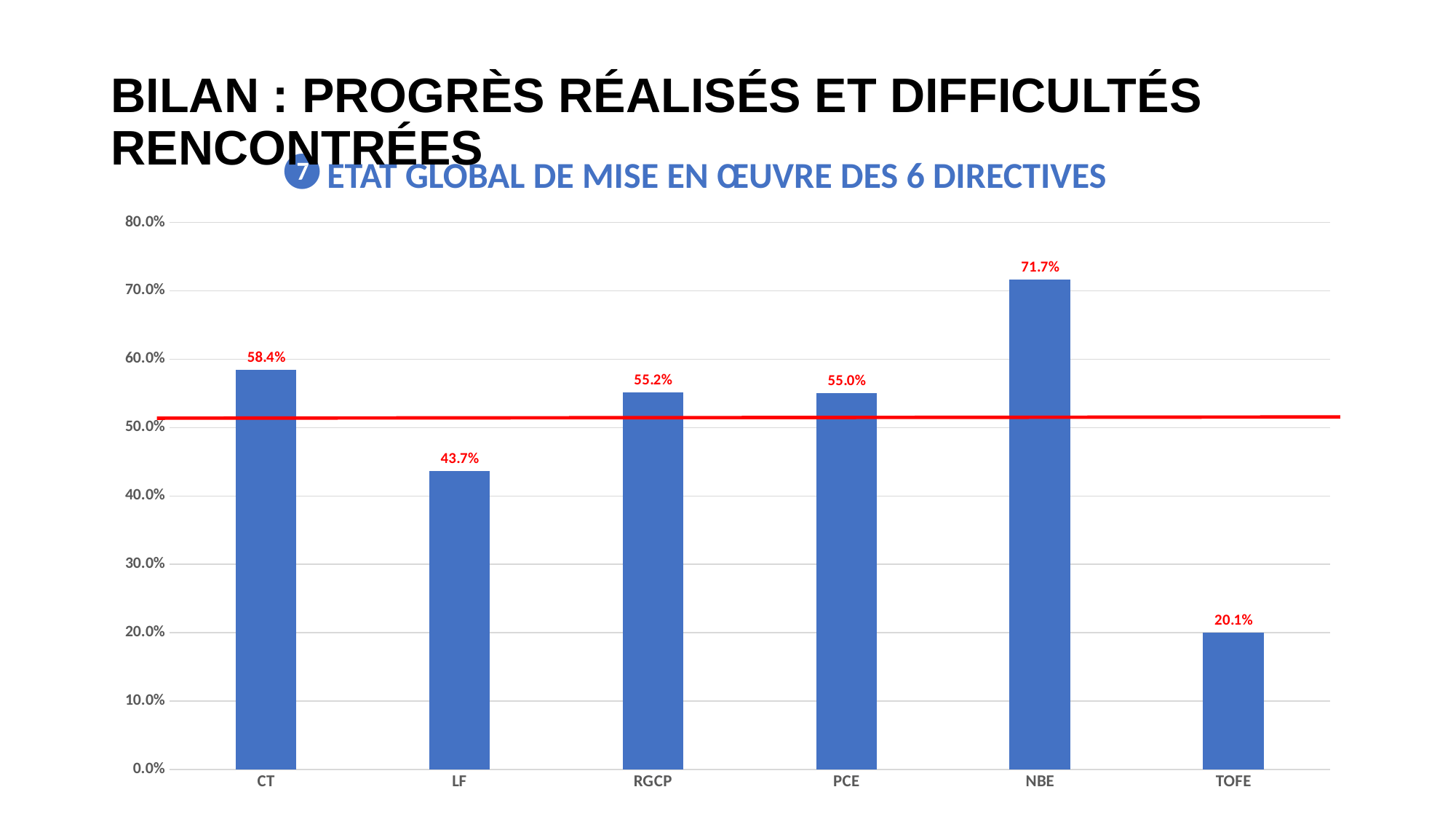
Is the value for LF greater or less than 50.0%? less What is the value for NBE? 71.7% What kind of chart is shown on the slide? bar chart What is the value for TOFE? 20.1% How many categories are shown on the x axis? 6 What is the value for LF? 43.7% What is the difference between the values for NBE and TOFE? 51.6% Which category has the lowest value? TOFE What is the title of the chart? ETAT GLOBAL DE MISE EN ŒUVRE DES 6 DIRECTIVES What is the difference between the values for CT and LF? 14.7% Which is larger, the value for CT or the value for RGCP? CT Which category has the highest value? NBE